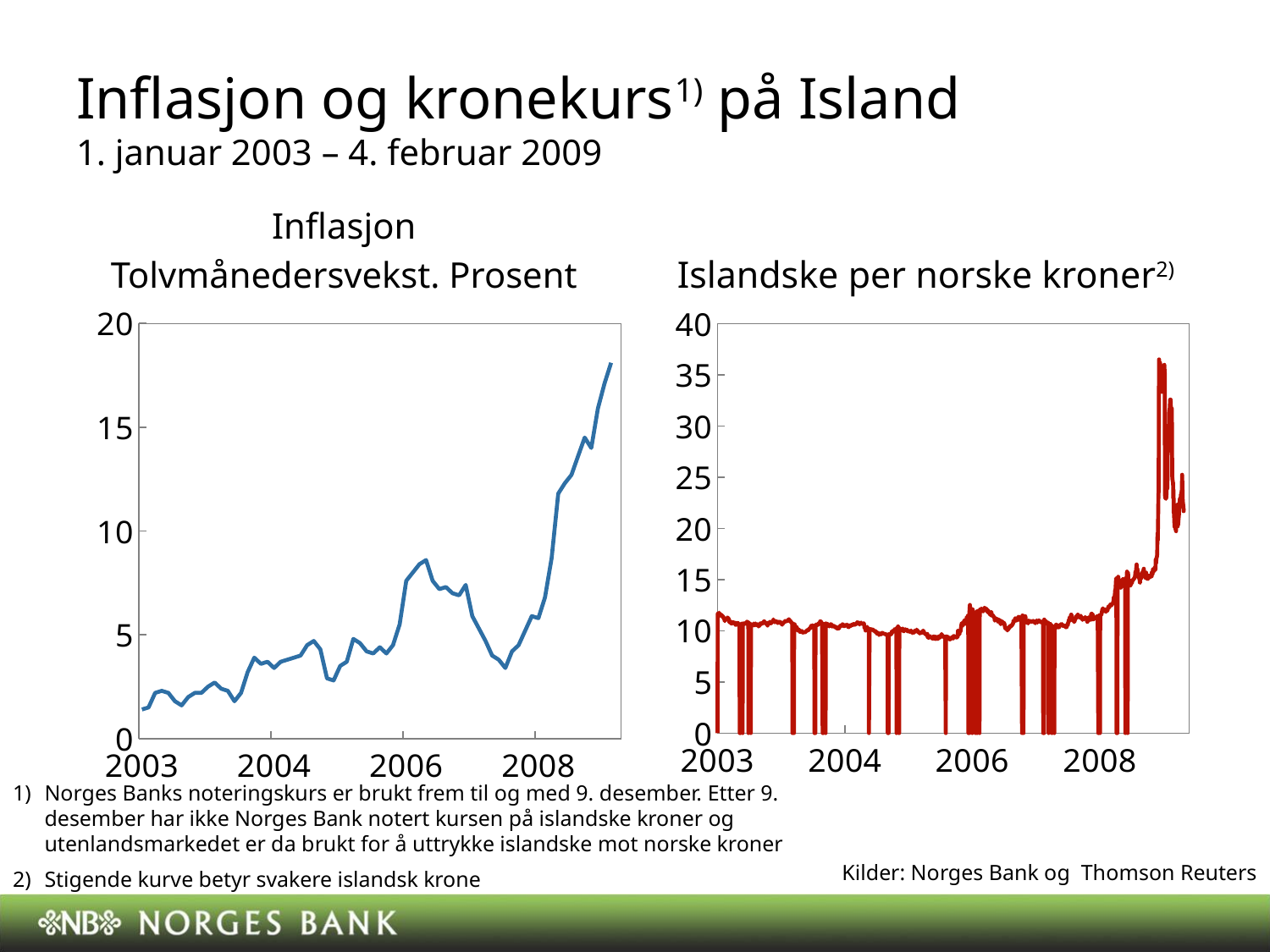
In the right chart 'Islandske per norske kroner', is the value at the 2004 tick greater or less than 15? less What kind of chart is the right chart, titled 'Islandske per norske kroner'? line chart What colour is the line in the left chart 'Inflasjon Tolvmånedersvekst. Prosent'? blue In the left chart 'Inflasjon Tolvmånedersvekst. Prosent', is the value at the end of the series greater or less than 15? greater In the left chart 'Inflasjon Tolvmånedersvekst. Prosent', is the value at the start of 2003 greater or less than 5? less In the left chart 'Inflasjon Tolvmånedersvekst. Prosent', does the line overall rise or fall from 2003 to the end of the series? rise In the right chart 'Islandske per norske kroner', does the line overall rise or fall from 2003 to the end of the series? rise What kind of chart is the left chart, titled 'Inflasjon Tolvmånedersvekst. Prosent'? line chart What is the title of the right chart? Islandske per norske kroner